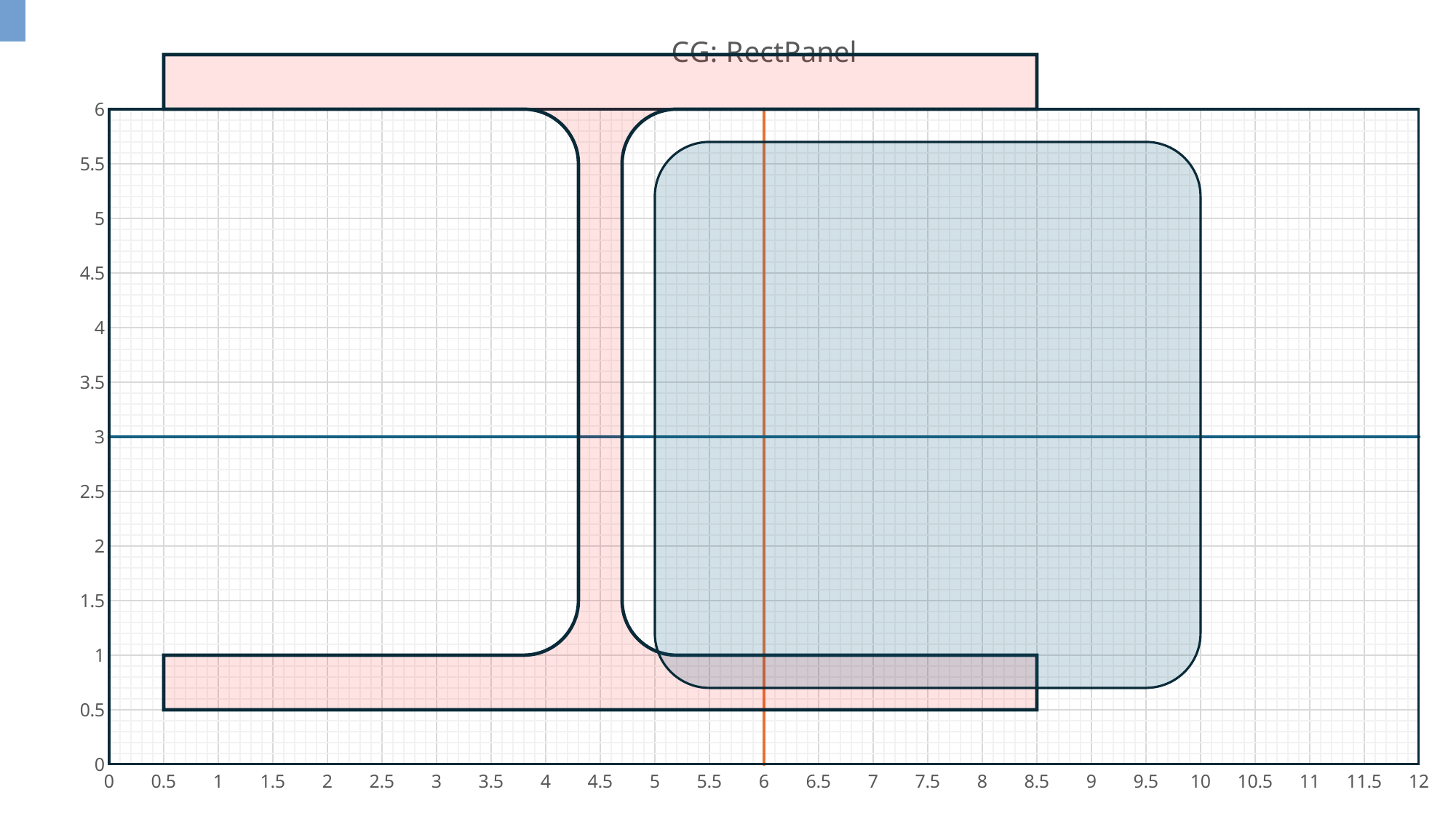
At what y value is the horizontal blue line drawn? 3 At what x value is the orange vertical line drawn? 6 At what x value does the right edge of the pink I-beam's bottom flange end? 8.5 At what x value does the left edge of the pink I-beam's bottom flange start? 0.5 Is the right edge of the blue rounded rectangle at an x value greater or less than 9? greater Which shape extends further to the right, the pink I-beam or the blue rounded rectangle? the blue rounded rectangle What is the title of the chart? CG: RectPanel What kind of chart is this? a line chart (two crosshair lines on a grid) with overlaid shapes Is the top edge of the blue rounded rectangle at a y value greater or less than 5? greater What is the maximum value shown on the y axis? 6 What colour is the I-beam shape filled with? pink What is the maximum value shown on the x axis? 12